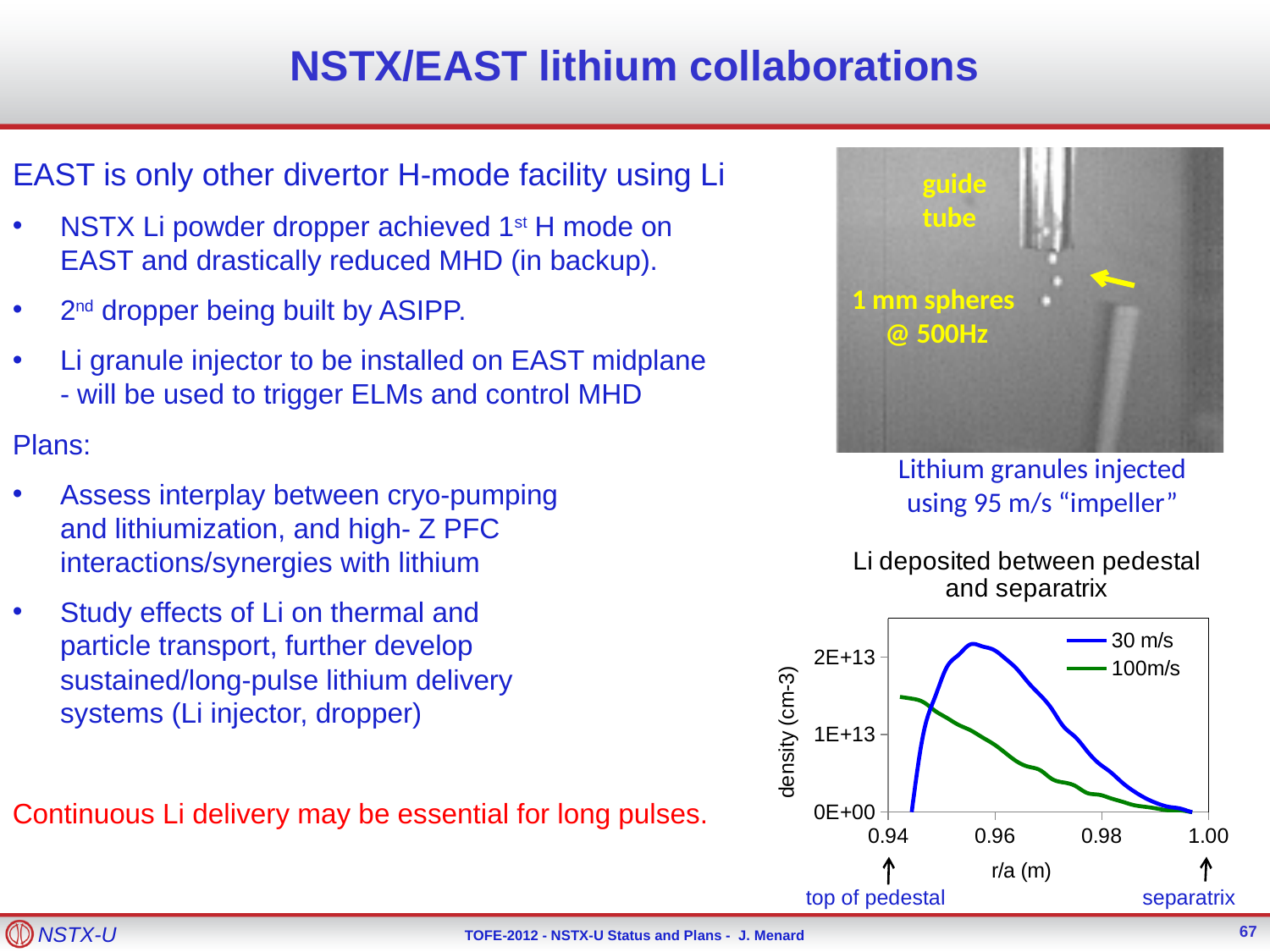
In the density chart, at r/a = 0.94, which series has the higher density, 30 m/s or 100m/s? 100m/s What are the two series named in the legend of the density chart? 30 m/s and 100m/s What is the label of the x axis of the density chart? r/a (m) In the density chart, is the density of the 30 m/s series at r/a = 0.96 greater or less than 1E+13? greater How many series does the legend of the density chart list? 2 In the density chart, is the density of the 100m/s series at r/a = 0.94 greater or less than 2E+13? less What kind of chart is shown under the title "Li deposited between pedestal and separatrix"? line chart In the density chart, is the density of the 30 m/s series at r/a = 0.98 greater or less than 1E+13? less What colour is the 30 m/s line in the density chart? blue In the density chart, does the 100m/s series rise or fall as r/a increases from 0.94 to 1.00? fall In the density chart, at r/a = 0.96, which series has the higher density, 30 m/s or 100m/s? 30 m/s In the density chart, which series reaches the higher peak density, 30 m/s or 100m/s? 30 m/s